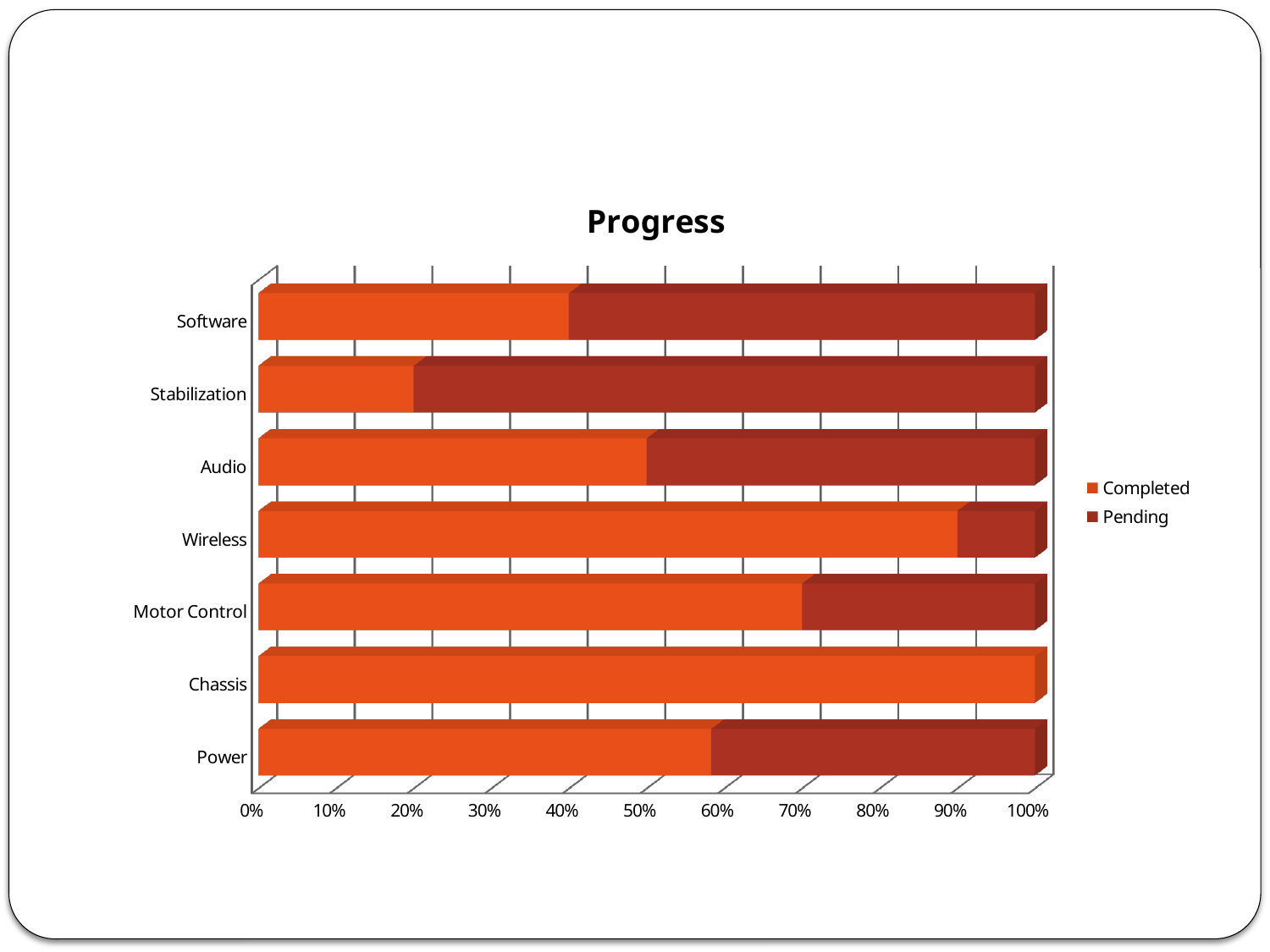
What kind of chart is shown on the slide? bar chart Which has a larger Completed value, Audio or Software? Audio Is the Completed value for Motor Control greater or less than 60%? greater Which category has the lowest Completed value? Stabilization How many series does the legend list? 2 How many categories are shown on the chart? 7 What is the title of the chart? Progress What is the Completed value for Chassis? 100% Which category has the highest Completed value? Chassis Which has a larger Pending value, Stabilization or Power? Stabilization Is the Completed value for Stabilization greater or less than 30%? less Is the Completed value for Wireless greater or less than 80%? greater